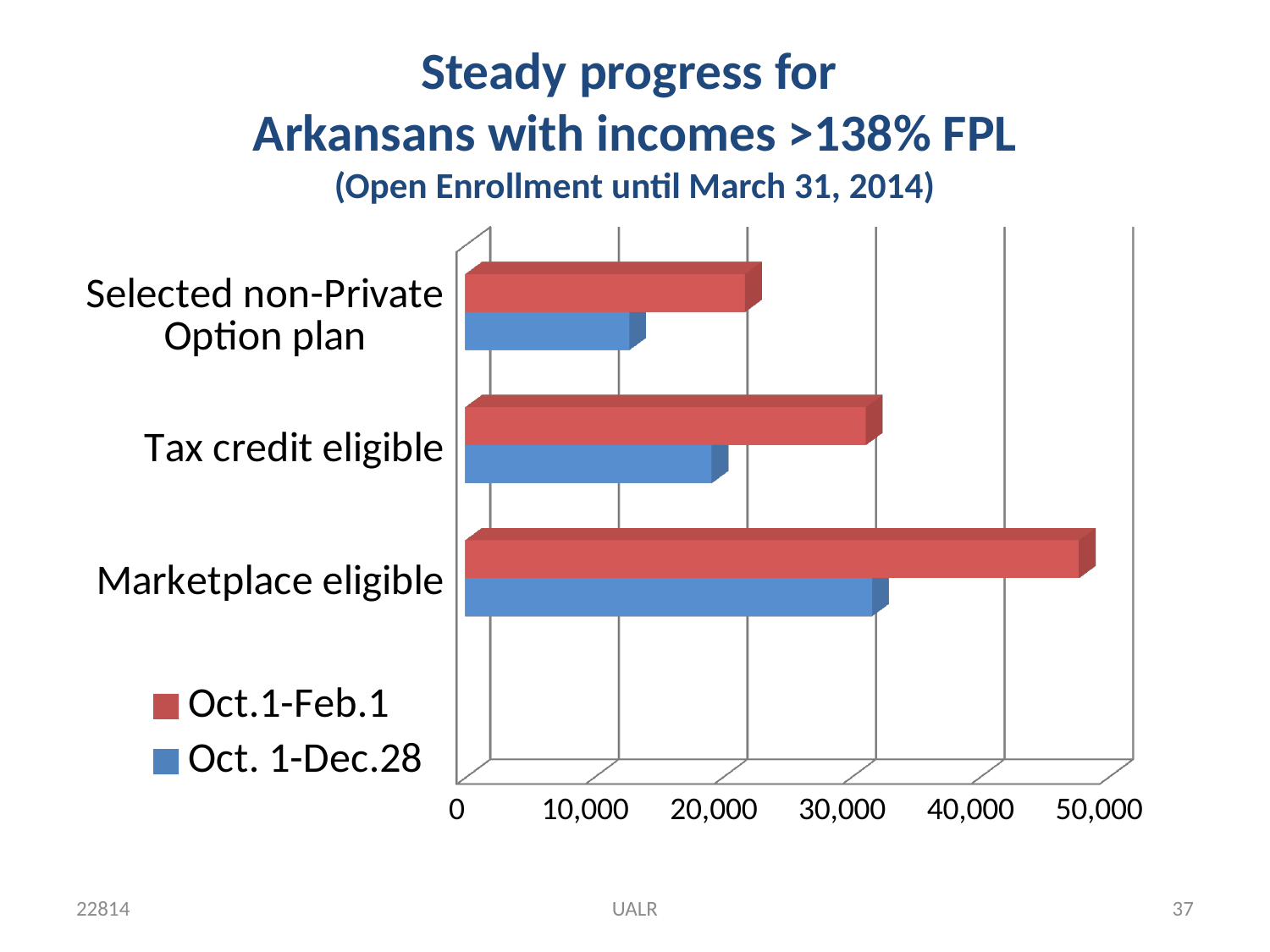
Which category has the highest value for the Oct.1-Feb.1 series? Marketplace eligible Is the Oct. 1-Dec.28 value for Tax credit eligible greater or less than 30,000? less Is the Oct. 1-Dec.28 value for Selected non-Private Option plan greater or less than 20,000? less Is the Oct.1-Feb.1 value for Marketplace eligible greater or less than 40,000? greater Which category has the larger Oct.1-Feb.1 value, Tax credit eligible or Selected non-Private Option plan? Tax credit eligible How many categories are plotted on the chart? 3 Which category has the lowest value for the Oct. 1-Dec.28 series? Selected non-Private Option plan Which colour represents the Oct.1-Feb.1 series in the legend? Red How many series does the legend list? 2 For Marketplace eligible, which series has the larger value, Oct.1-Feb.1 or Oct. 1-Dec.28? Oct.1-Feb.1 What kind of chart is shown on the slide? Bar chart